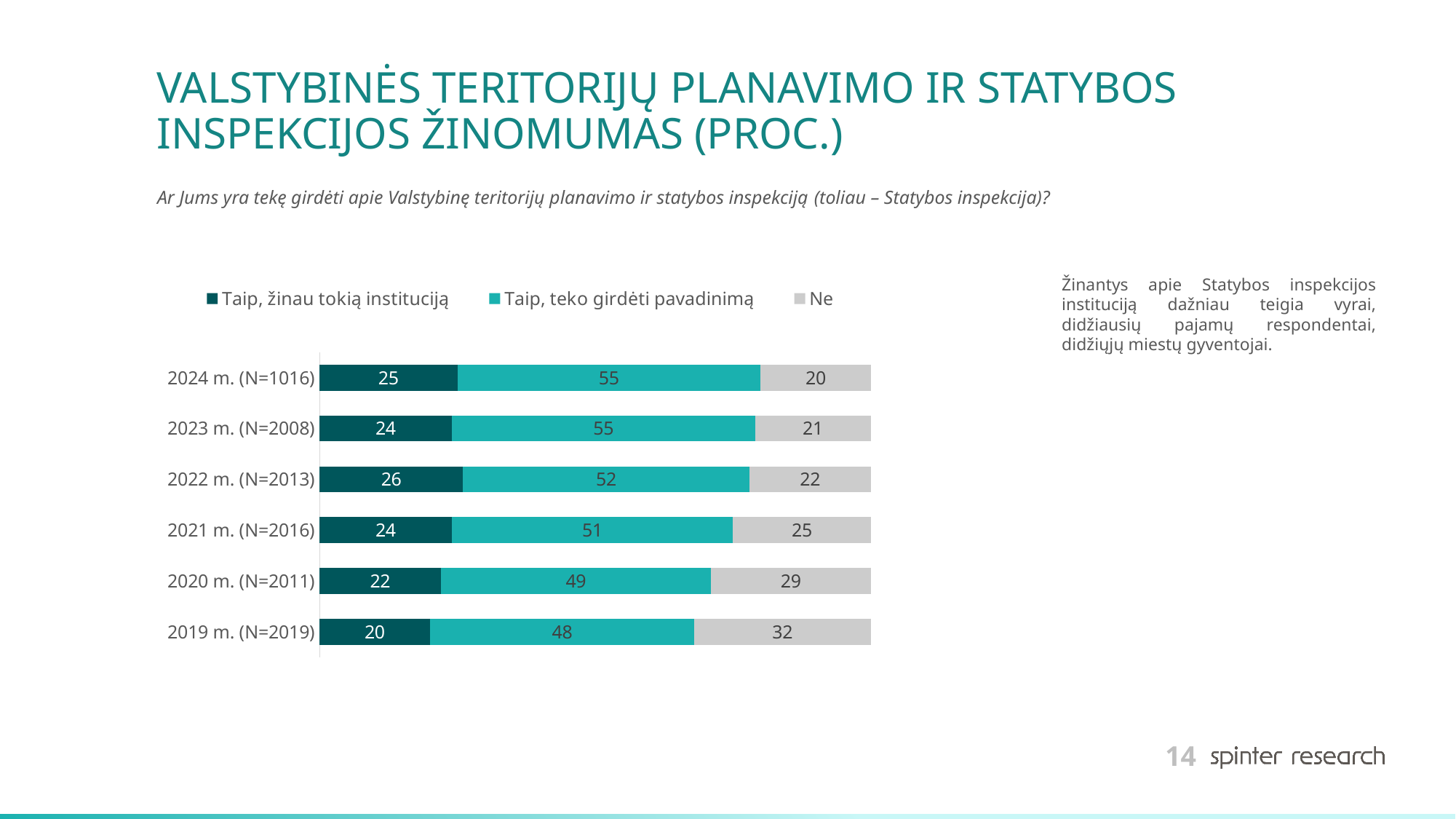
What kind of chart is shown on the slide? Stacked bar chart What is the difference between the "Ne" values for 2019 m. (N=2019) and 2024 m. (N=1016)? 12 What is the total of the stacked bar for 2023 m. (N=2008)? 100 Does the "Ne" value rise or fall from 2019 m. to 2024 m.? Fall Which year has the highest value for "Ne"? 2019 m. (N=2019) What is the value for "Taip, žinau tokią instituciją" in 2024 m. (N=1016)? 25 What is the value for "Ne" in 2019 m. (N=2019)? 32 How many series does the legend list? 3 Which year has the lowest value for "Taip, žinau tokią instituciją"? 2019 m. (N=2019) Which is larger: the "Taip, teko girdėti pavadinimą" value for 2022 m. (N=2013) or for 2020 m. (N=2011)? 2022 m. (N=2013) How many years (categories) are shown in the chart? 6 What is the value for "Taip, teko girdėti pavadinimą" in 2021 m. (N=2016)? 51